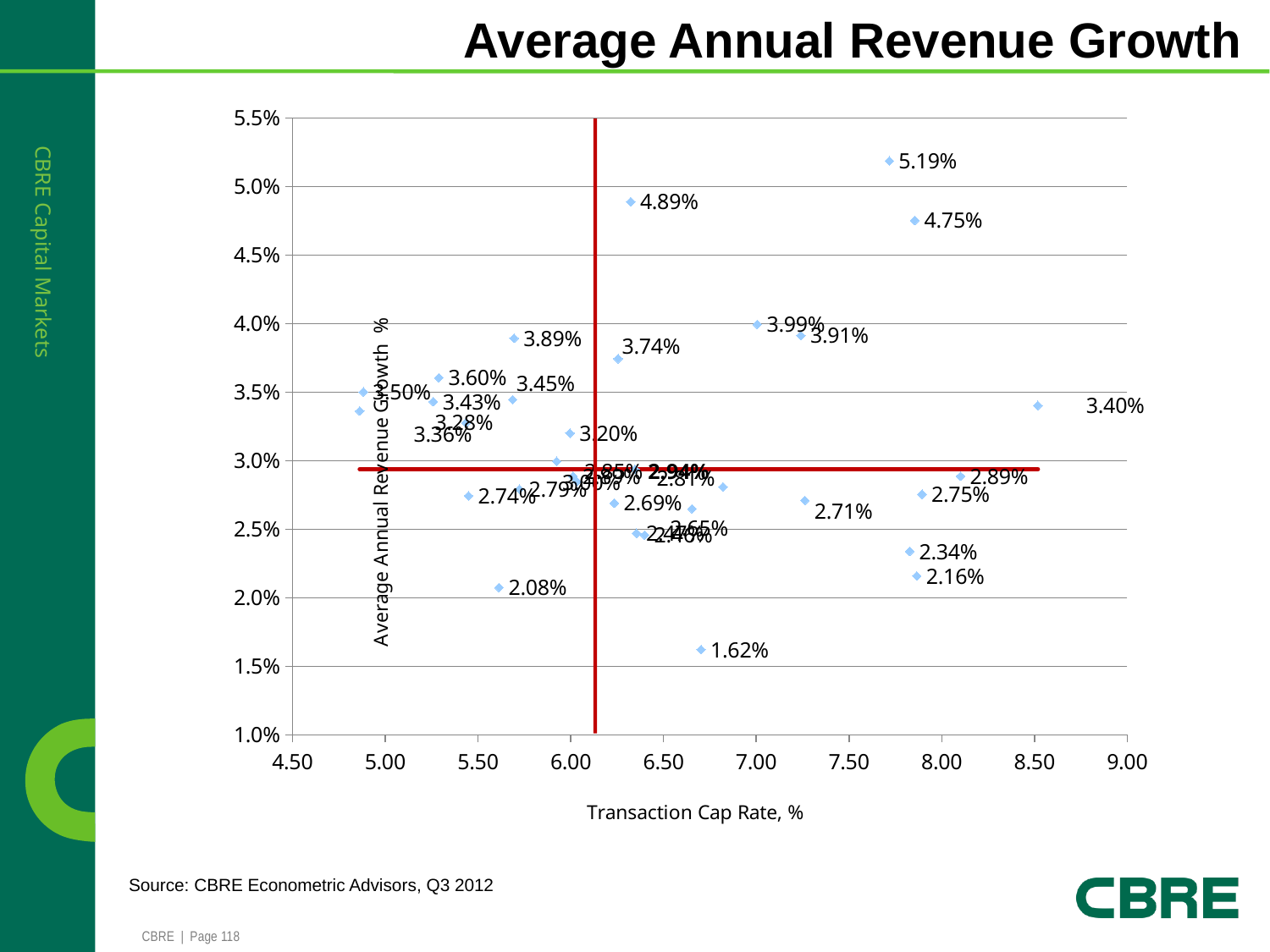
What is the highest average annual revenue growth value plotted on the chart? 5.19% What is the lowest average annual revenue growth value plotted on the chart? 1.62% Which is larger, the point labelled 4.89% or the point labelled 4.75%? 4.89% Which is larger, the point labelled 3.89% or the point labelled 3.74%? 3.89% Is the transaction cap rate for the point labelled 2.08% greater or less than 6.00? less Is the transaction cap rate for the point labelled 5.19% greater or less than 7.50? greater What is the difference between the two highest plotted values, 5.19% and 4.75%? 0.44 percentage points What is the title of the chart? Average Annual Revenue Growth What is the difference between the highest plotted value (5.19%) and the lowest plotted value (1.62%)? 3.57 percentage points What is the title of the x axis of the chart? Transaction Cap Rate, % Is the transaction cap rate for the point labelled 3.40% greater or less than 8.00? greater What kind of chart is shown on the slide? scatter chart